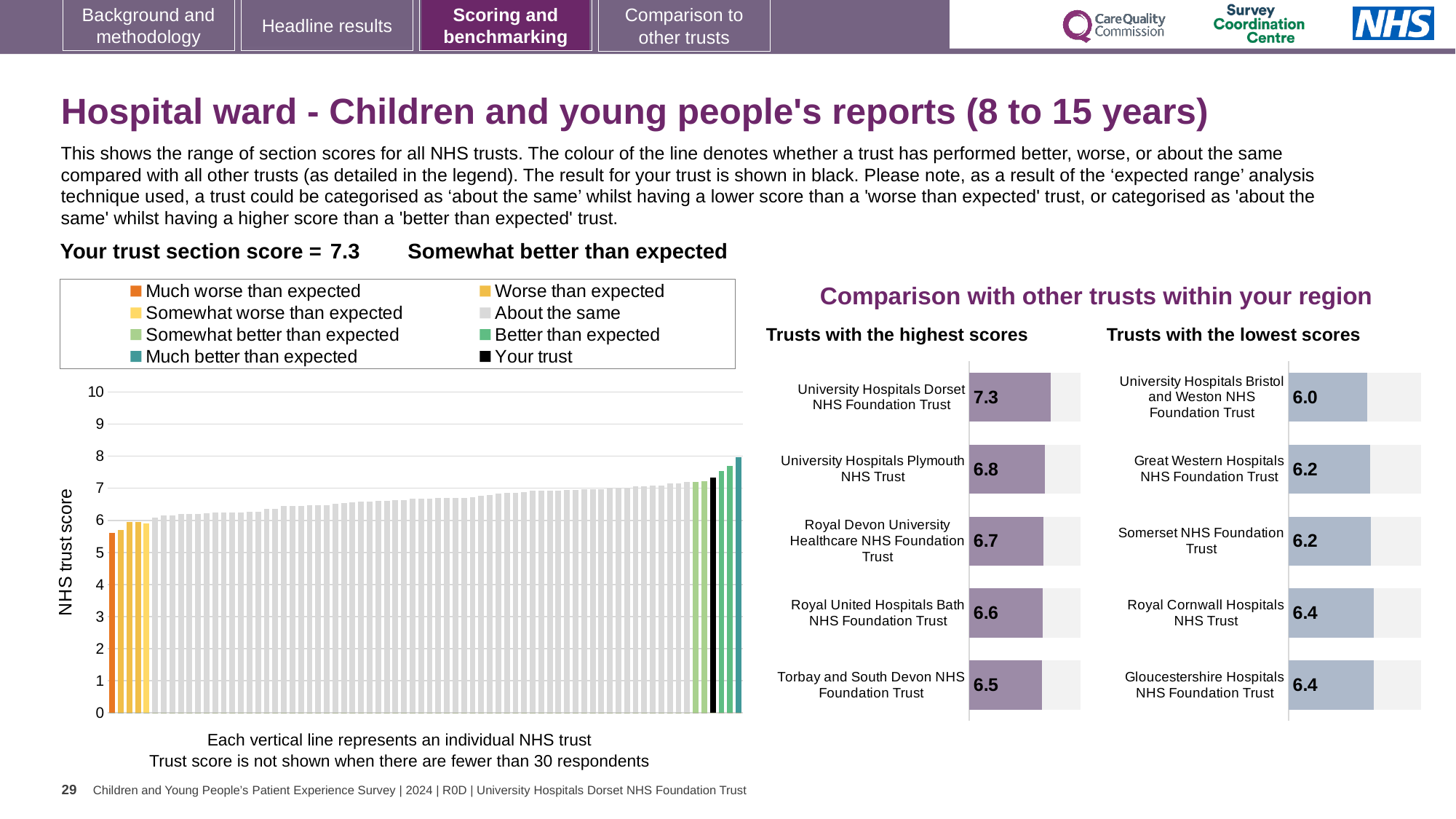
In the 'Trusts with the lowest scores' chart, what is the difference between the scores of Royal Cornwall Hospitals NHS Trust and University Hospitals Bristol and Weston NHS Foundation Trust? 0.4 In the 'Trusts with the highest scores' chart, which has the higher score: Royal Devon University Healthcare NHS Foundation Trust or Royal United Hospitals Bath NHS Foundation Trust? Royal Devon University Healthcare NHS Foundation Trust In the 'Trusts with the highest scores' chart, what is the difference between the scores of University Hospitals Dorset NHS Foundation Trust and Torbay and South Devon NHS Foundation Trust? 0.8 How many trusts are shown in the 'Trusts with the highest scores' chart? 5 In the legend of the NHS trust score chart, what colour represents 'Your trust'? black In the NHS trust score chart, is the value for the black 'Your trust' bar greater or less than 7? greater In the 'Trusts with the lowest scores' chart, which trust has the lowest score? University Hospitals Bristol and Weston NHS Foundation Trust In the 'Trusts with the highest scores' chart, which trust has the highest score? University Hospitals Dorset NHS Foundation Trust What kind of chart is the NHS trust score chart on the left? bar chart In the 'Trusts with the lowest scores' chart, what is the score for Great Western Hospitals NHS Foundation Trust? 6.2 In the 'Trusts with the highest scores' chart, what is the score for University Hospitals Plymouth NHS Trust? 6.8 How many entries does the legend of the NHS trust score chart list? 8